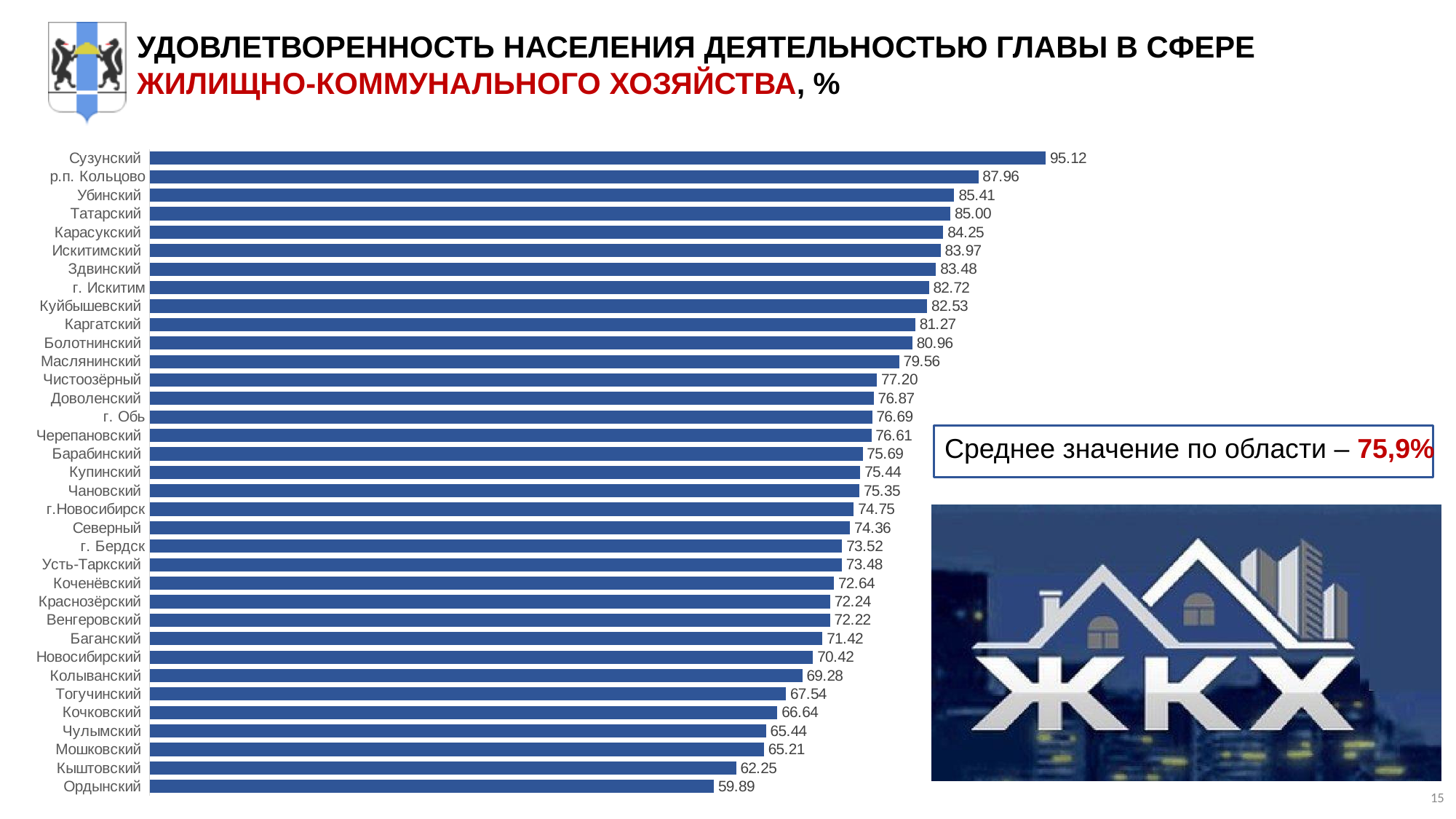
What is the difference between the values for Сузунский and Ордынский? 35.23 Which category has the lowest value? Ордынский What is the value for Ордынский? 59.89 Which category has the highest value? Сузунский How many categories are shown in the chart? 35 What is the value for Сузунский? 95.12 What is the difference between the values for Сузунский and р.п. Кольцово? 7.16 What is the regional average value stated on the slide? 75,9% What kind of chart is shown on the slide? Bar chart Which has a larger value, Татарский or Кыштовский? Татарский What is the value for г. Бердск? 73.52 What is the value for г.Новосибирск? 74.75